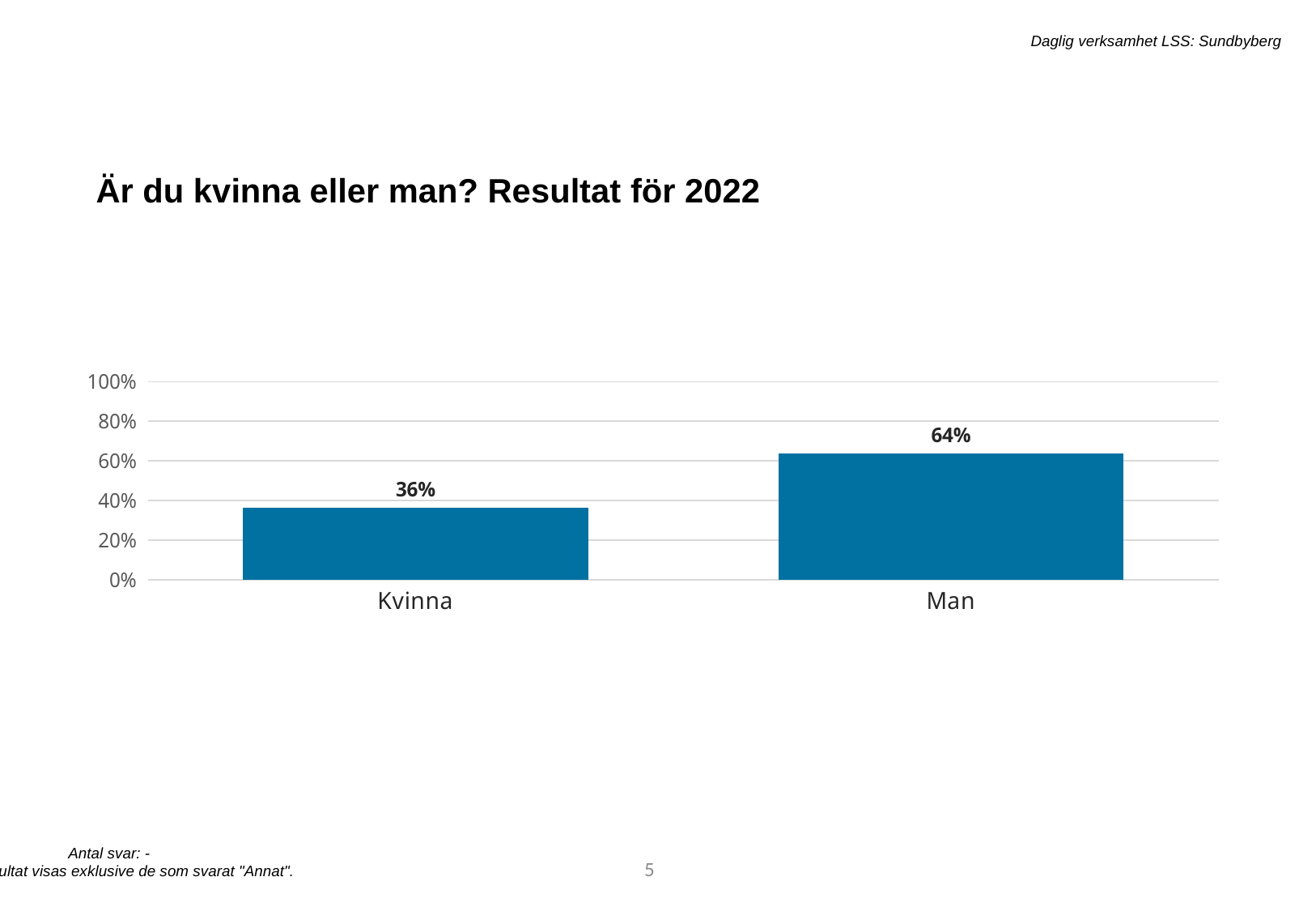
What is the value for Man? 64% Is the value for Man greater or less than 60%? greater Is the value for Kvinna greater or less than 40%? less What is the difference between the values for Man and Kvinna? 28% What is the title of the slide? Är du kvinna eller man? Resultat för 2022 What is the value for Kvinna? 36% Which is larger, the value for Kvinna or the value for Man? Man What is the total of the two values shown in the chart? 100% What kind of chart is shown on the slide? bar chart Which category has the lowest value? Kvinna How many categories are shown on the x axis? 2 Which category has the highest value? Man